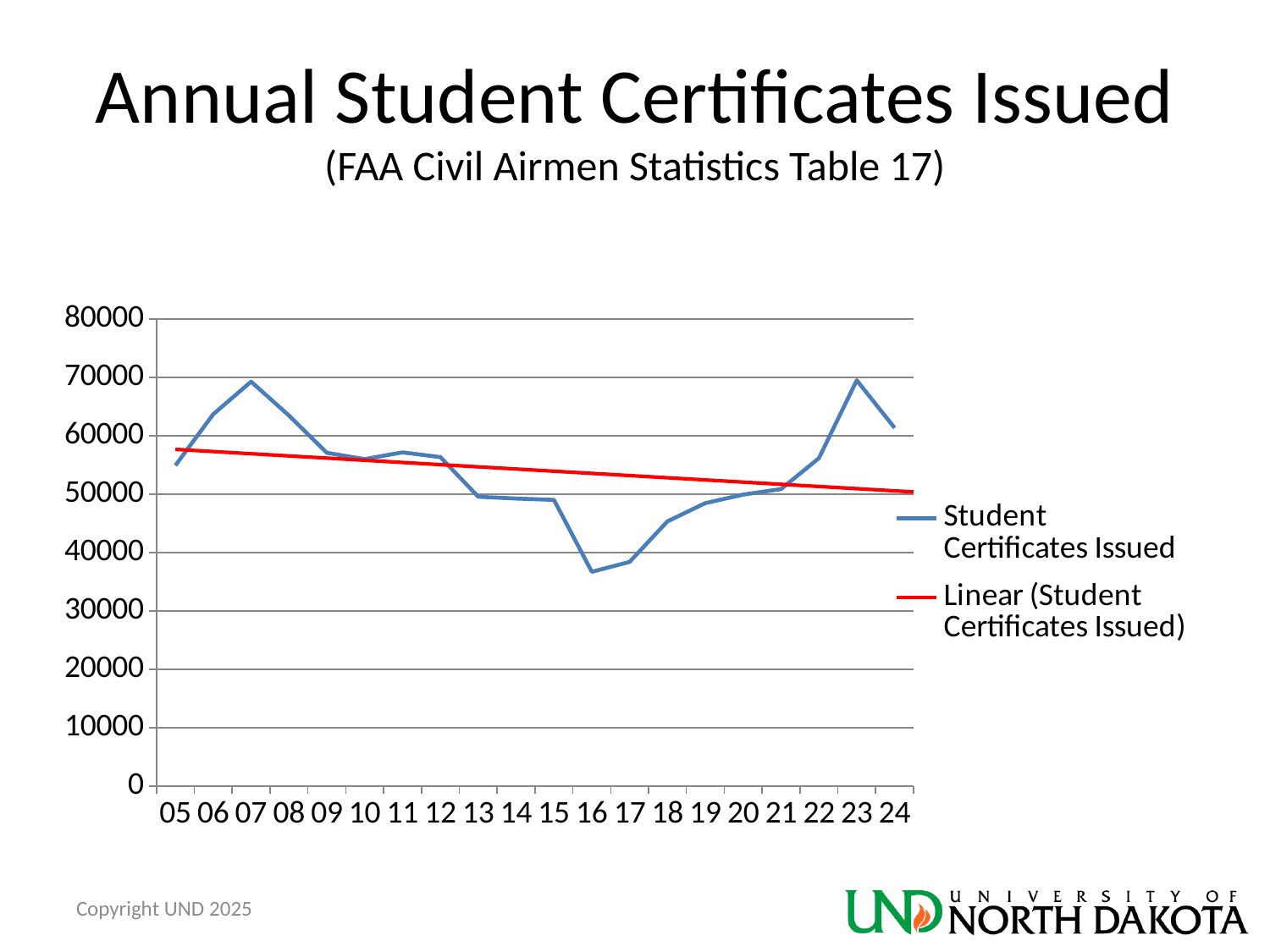
Is the value for 07 greater or less than 60000? greater Is the value for 22 greater or less than 50000? greater In which year is the number of student certificates issued lowest? 16 Is the value for 18 greater or less than 50000? less Does the red linear trend line rise or fall from 05 to 24? fall What kind of chart is shown on the slide? line chart How many series does the legend list? 2 What is the title of the chart? Annual Student Certificates Issued Which year has the larger value, 07 or 16? 07 How many years are plotted along the x axis? 20